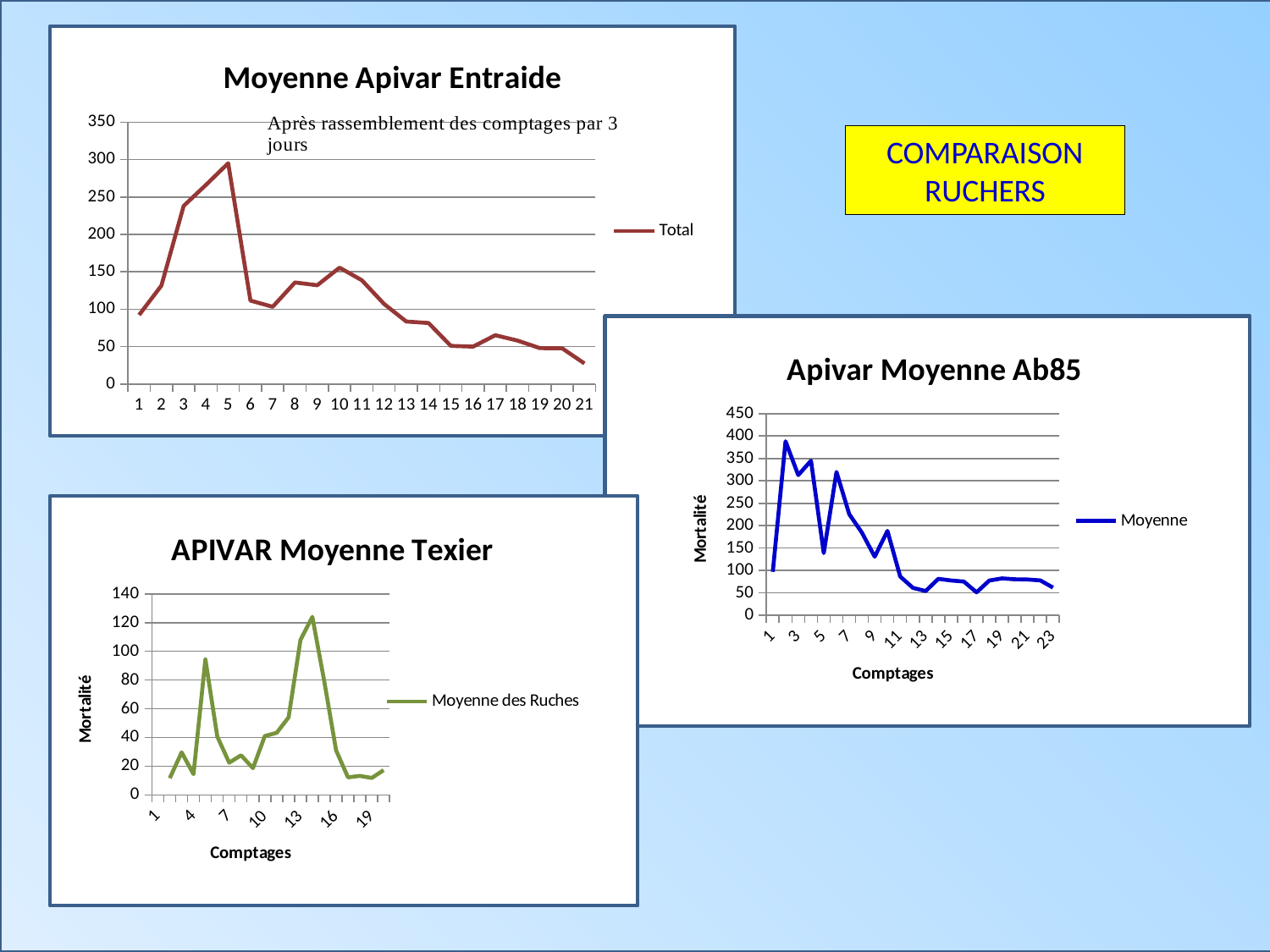
In the 'Apivar Moyenne Ab85' chart, is the value at point 2 greater or less than 350? greater In the 'Moyenne Apivar Entraide' chart, at which x-axis point is the value highest? 5 What kind of chart is 'Moyenne Apivar Entraide'? line chart What is the y-axis title of the 'APIVAR Moyenne Texier' chart? Mortalité In the 'Apivar Moyenne Ab85' chart, at which x-axis point is the value highest? 2 In the 'Moyenne Apivar Entraide' chart, is the value at point 21 greater or less than 50? less In the 'Moyenne Apivar Entraide' chart, is the value at point 5 greater or less than 250? greater How many points are plotted along the x axis of the 'Moyenne Apivar Entraide' chart? 21 How many series does the legend of the 'Apivar Moyenne Ab85' chart list? 1 What is the name of the series in the legend of the 'Moyenne Apivar Entraide' chart? Total